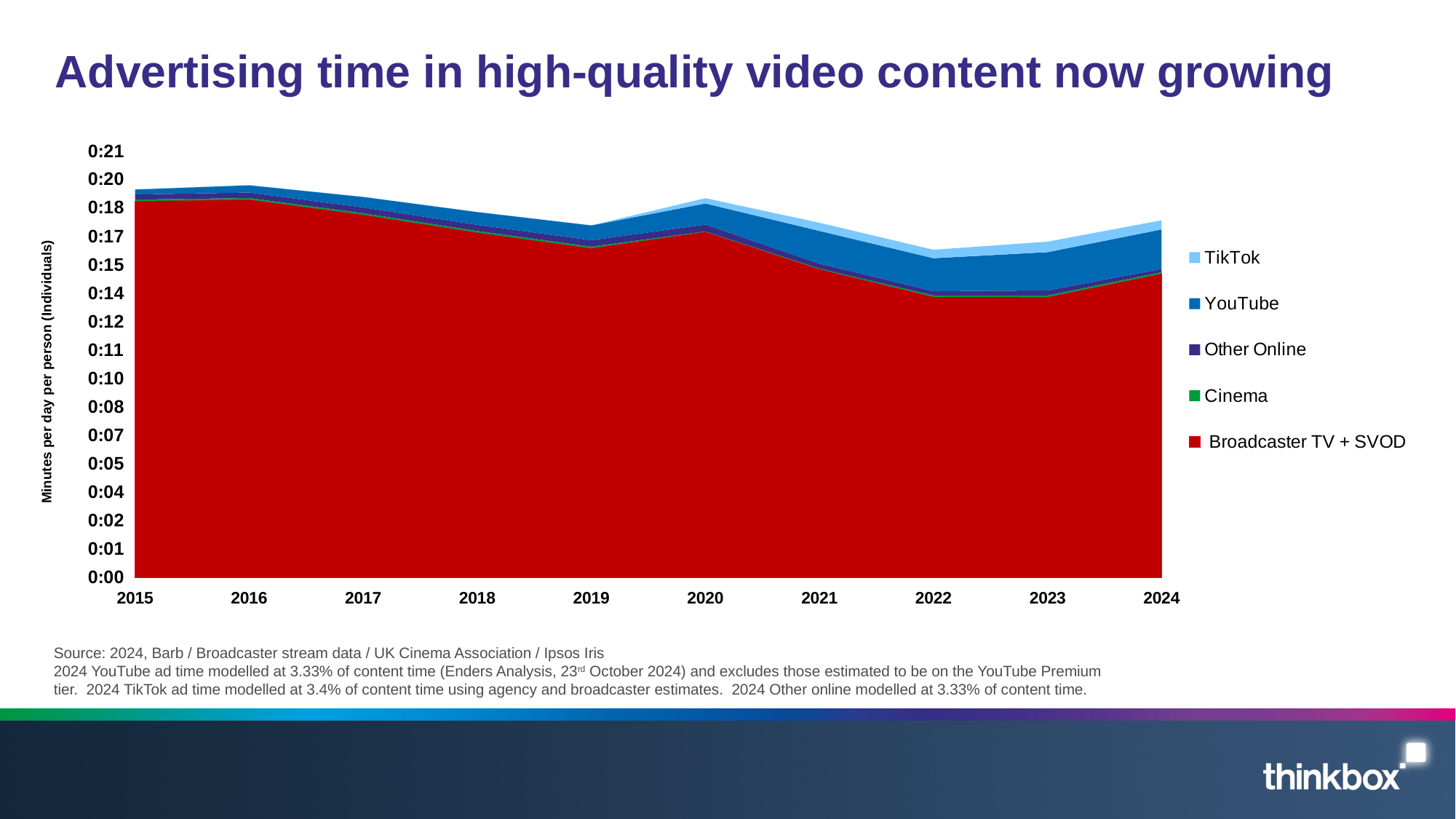
How many series does the legend list? 5 Is the total advertising time larger in 2019 or in 2020? 2020 Which year has the lowest total advertising time? 2022 Is the Broadcaster TV + SVOD value in 2019 greater or less than 0:17? less What is the label on the vertical axis? Minutes per day per person (Individuals) Is the total advertising time in 2024 greater or less than 0:17? greater How many years are shown along the x axis? 10 What kind of chart is shown on the slide? Stacked area chart Does the Broadcaster TV + SVOD value rise or fall from 2016 to 2022? fall Which series is shown in red at the bottom of the stack? Broadcaster TV + SVOD Is the total advertising time in 2022 greater or less than 0:17? less